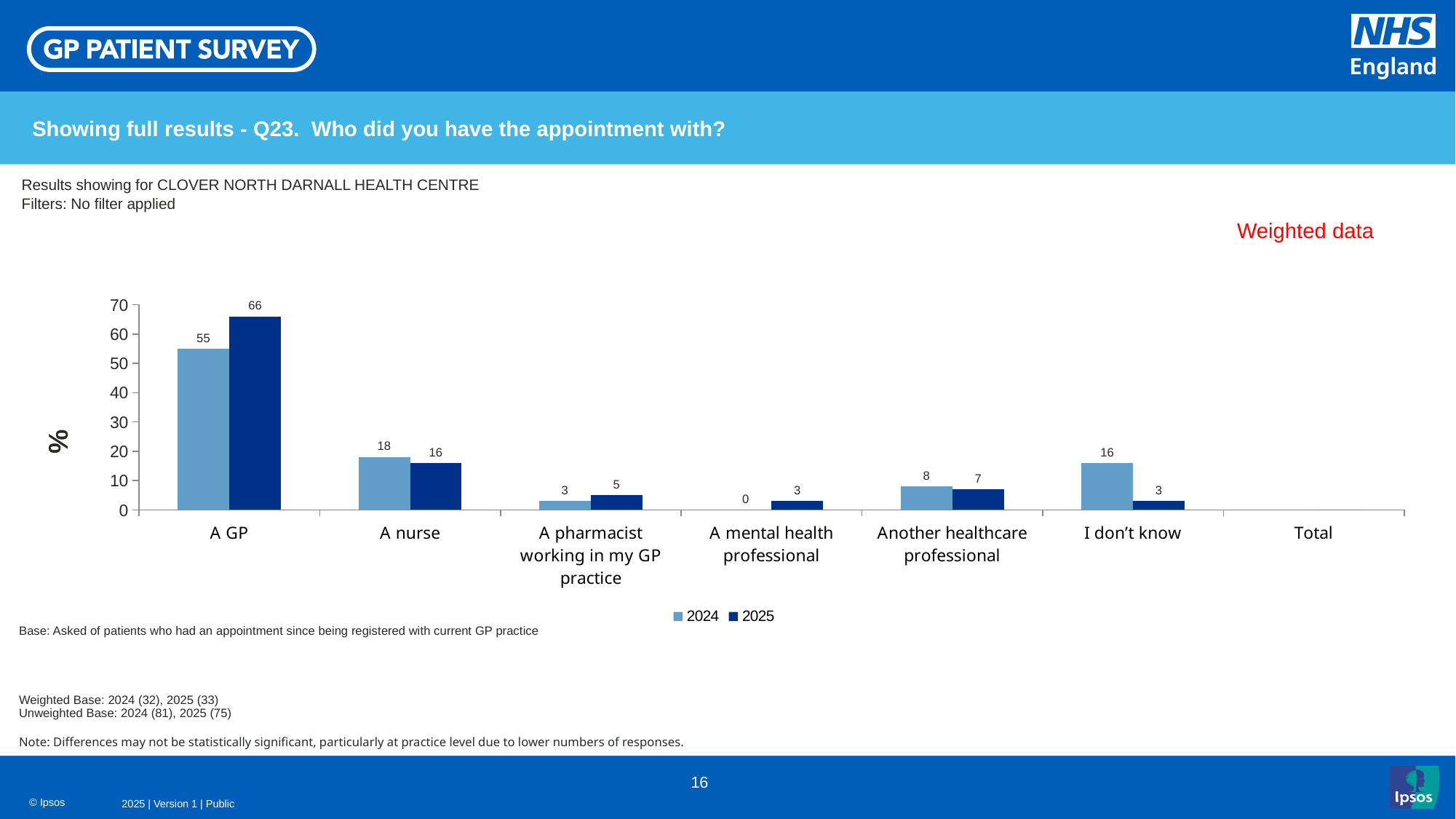
Which category has the lowest 2025 value? A mental health professional and I don't know (both 3) What is the 2024 value for A nurse? 18 What kind of chart is shown on the slide? Bar chart What is the difference between the 2024 and 2025 values for I don't know? 13 What is the 2025 value for I don't know? 3 What is the difference between the 2025 and 2024 values for A GP? 11 What are the two series listed in the legend? 2024 and 2025 Which is larger for Another healthcare professional, the 2024 value or the 2025 value? 2024 What is the 2024 value for A mental health professional? 0 Which category has the highest 2024 value? A GP What is the 2025 value for A GP? 66 How many series does the legend list? 2